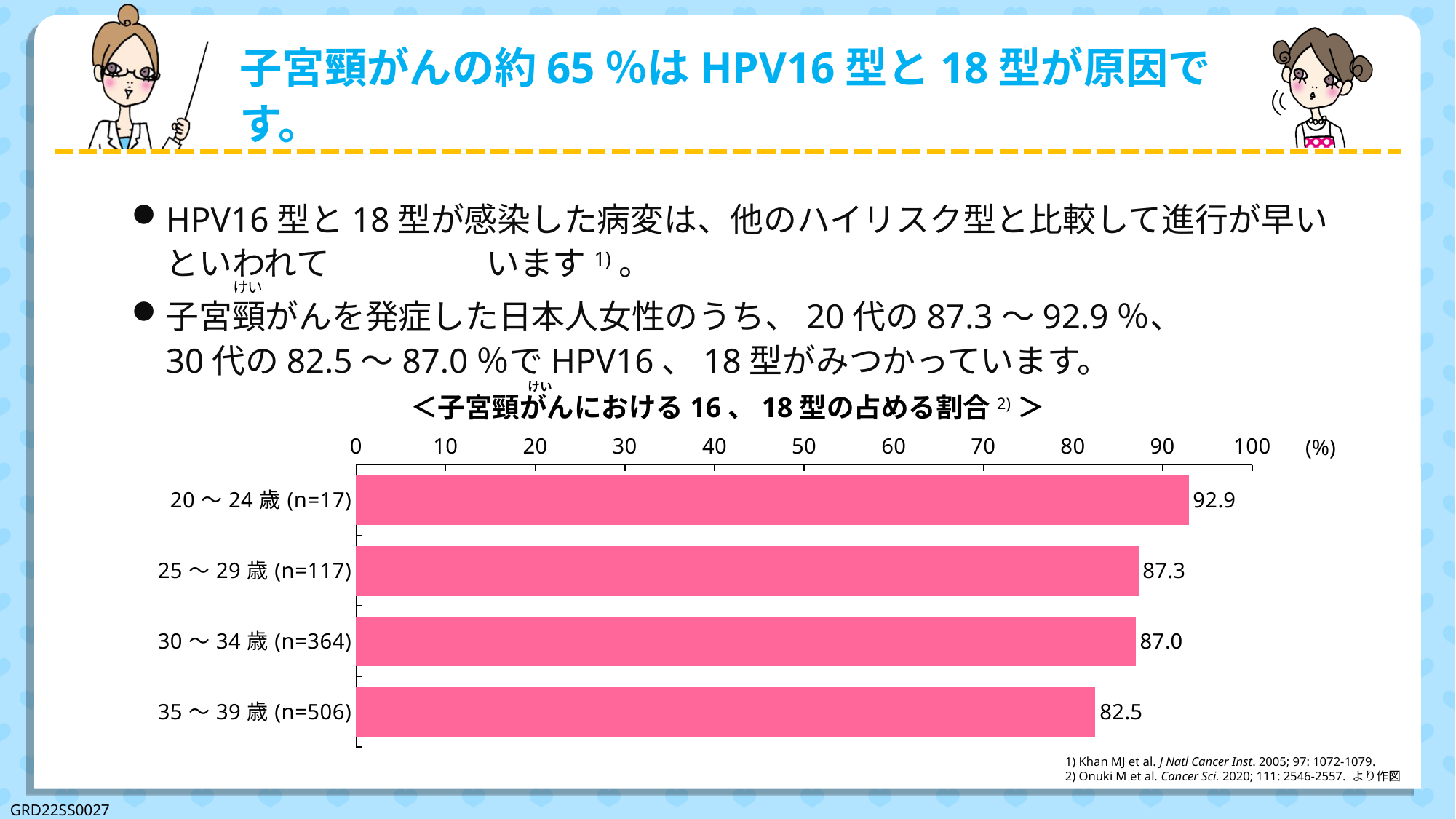
Which age group has the highest value? 20～24歳 (n=17) What is the value for 20～24歳 (n=17)? 92.9 What is the difference between the values for 20～24歳 and 35～39歳? 10.4 What kind of chart is shown on the slide? bar chart Do the values rise or fall as the age groups get older from top to bottom? fall How many age groups are shown in the chart? 4 Is the value for 35～39歳 greater or less than 90? less What is the difference between the values for 25～29歳 and 30～34歳? 0.3 What is the value for 35～39歳 (n=506)? 82.5 What is the value for 30～34歳 (n=364)? 87.0 Which is larger, the value for 25～29歳 or the value for 35～39歳? 25～29歳 Which age group has the lowest value? 35～39歳 (n=506)